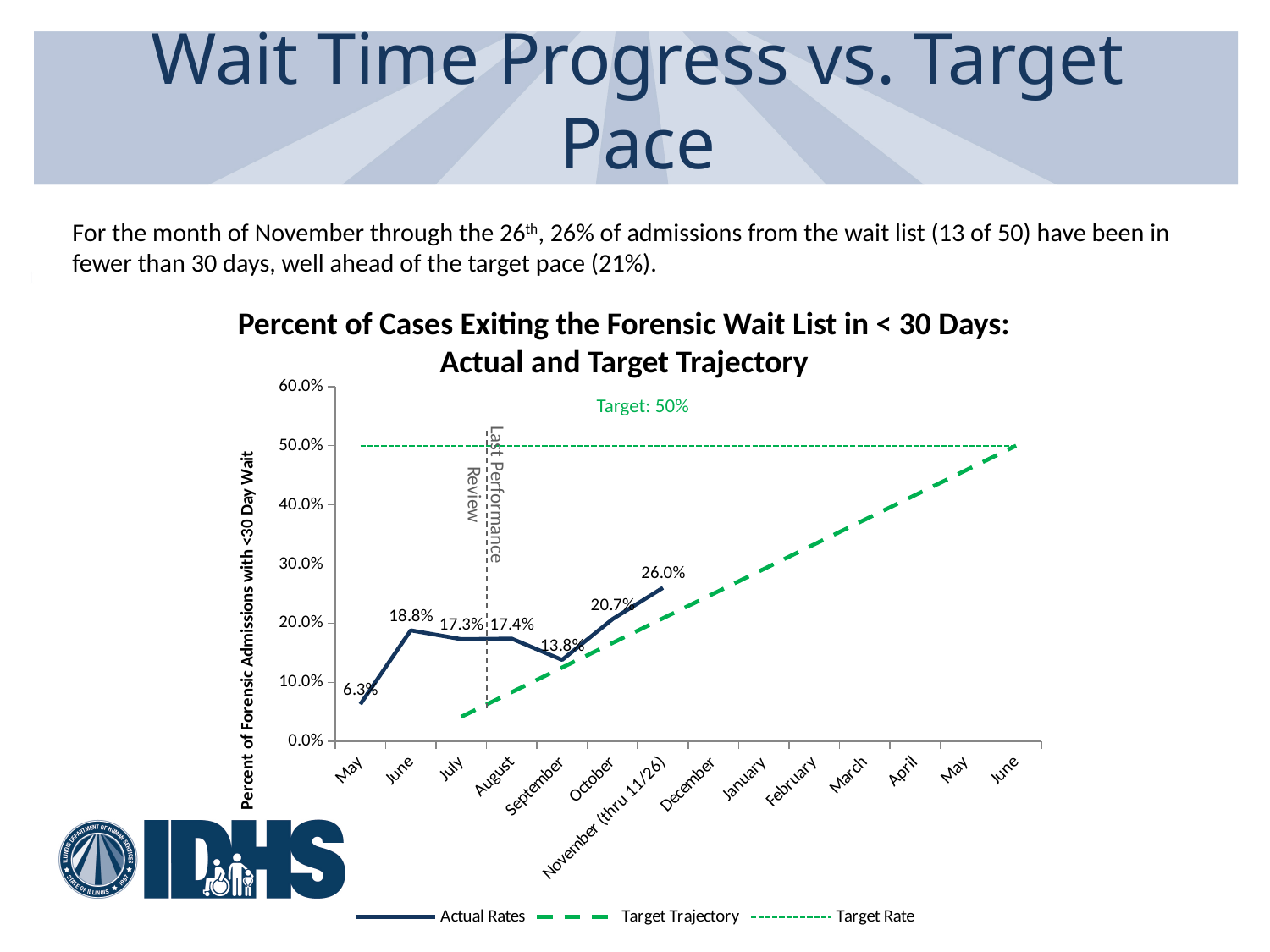
Which is larger, the actual rate for July or for August? August What is the actual rate for November (thru 11/26)? 26.0% What is the actual rate for June? 18.8% Which month has the lowest actual rate? May Is the actual rate for May greater or less than 10.0%? less What is the title of the chart? Percent of Cases Exiting the Forensic Wait List in < 30 Days: Actual and Target Trajectory What type of chart is shown on the slide? line chart What is the actual rate for September? 13.8% How many series does the legend list? 3 What is the difference between the actual rates for October and September? 6.9% What target rate is shown on the chart? 50% Which month has the highest actual rate? November (thru 11/26)